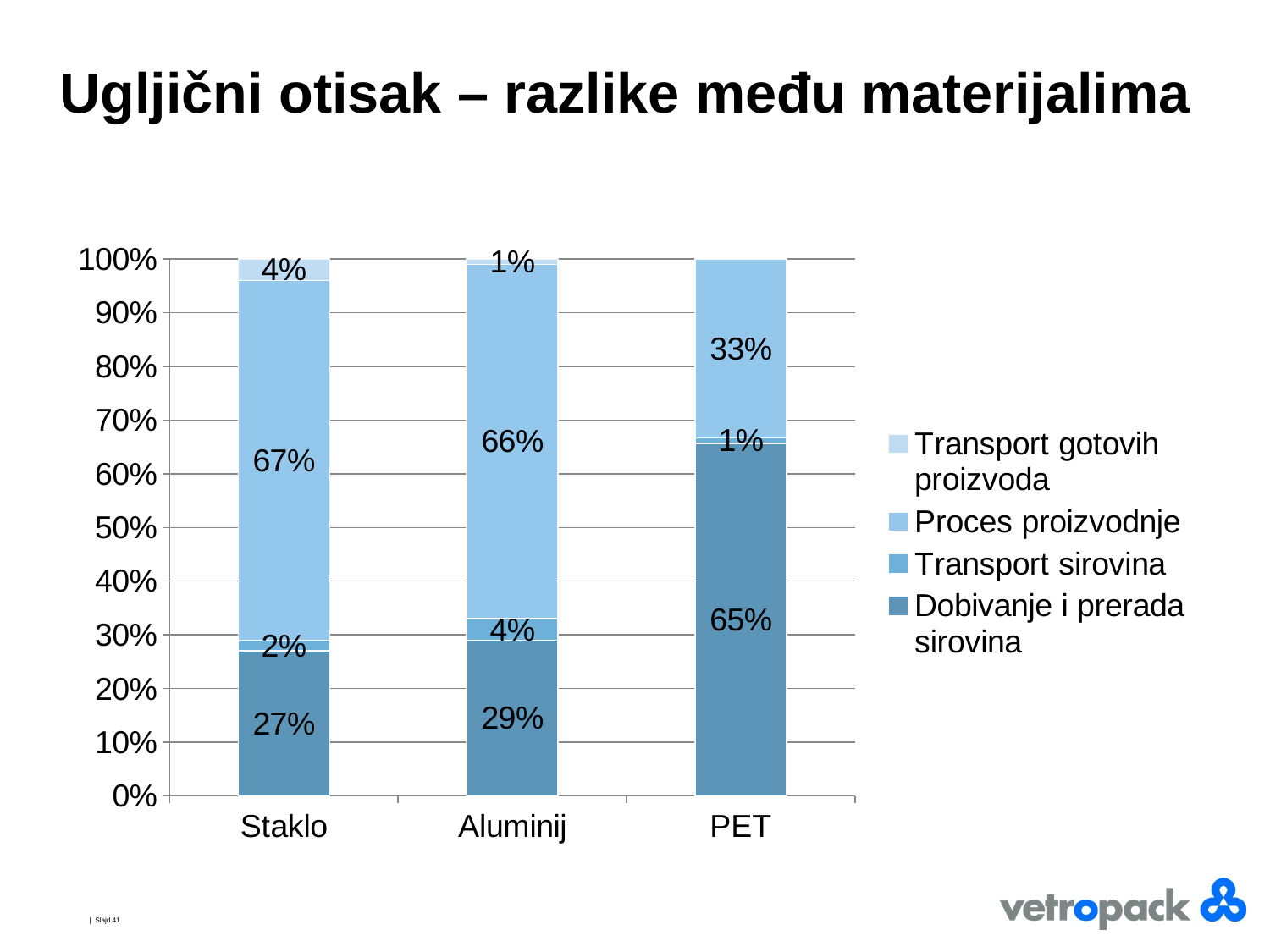
Which is larger: Transport sirovina for Aluminij or Transport sirovina for Staklo? Aluminij Which material has the highest value for Dobivanje i prerada sirovina? PET How many materials (categories) are shown on the x axis? 3 What is the value of Dobivanje i prerada sirovina for Staklo? 27% What is the value of Proces proizvodnje for PET? 33% What is the difference between the Proces proizvodnje value for Staklo and for PET? 34% What type of chart is shown on the slide? stacked bar chart How many series does the legend list? 4 Which material has the lowest value for Proces proizvodnje? PET What is the value of Transport gotovih proizvoda for Staklo? 4% What is the value of Proces proizvodnje for Aluminij? 66% What is the value of Dobivanje i prerada sirovina for PET? 65%